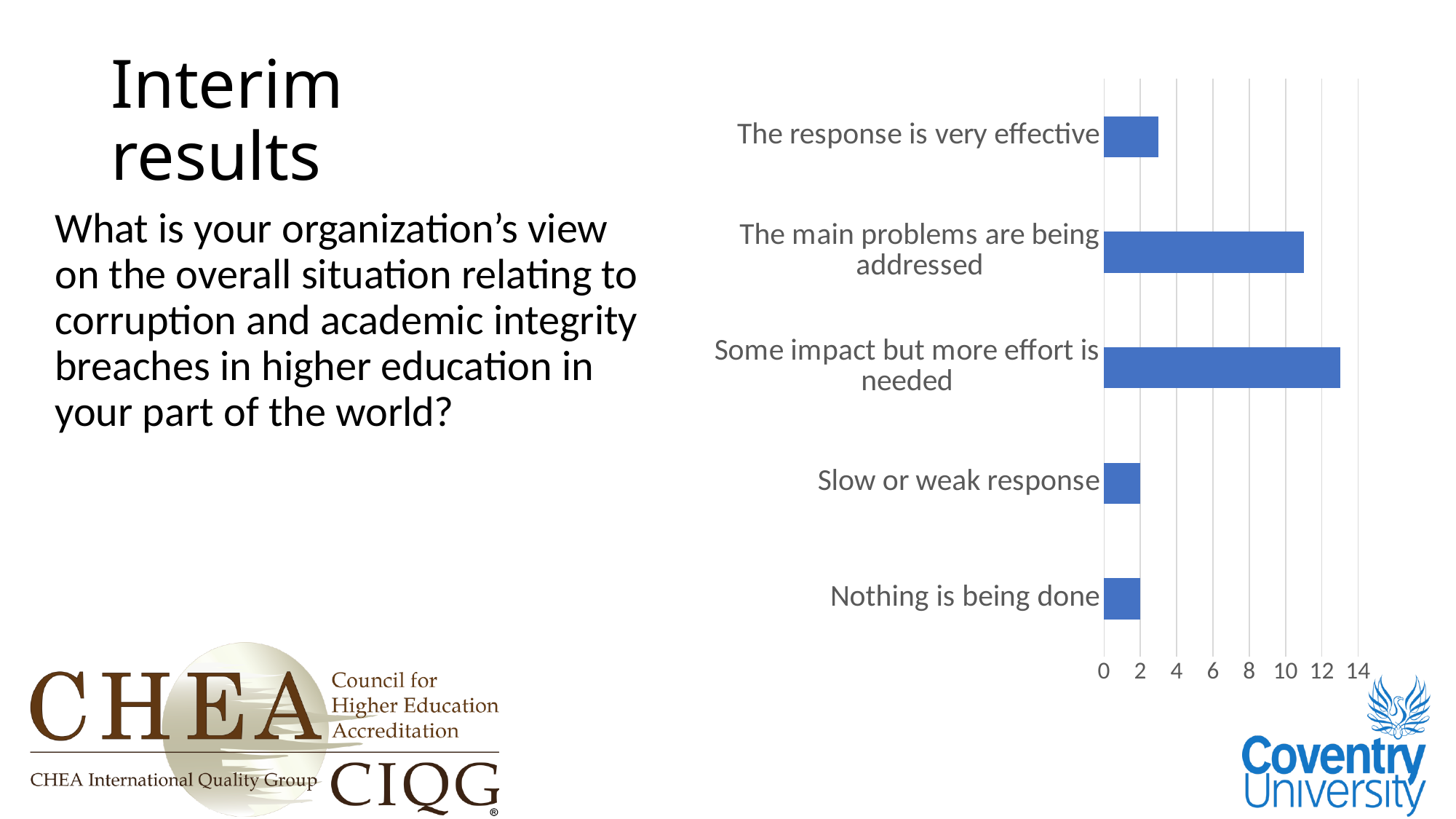
Which is larger: the value for "The response is very effective" or the value for "The main problems are being addressed"? The main problems are being addressed Is the value for "The main problems are being addressed" greater or less than 10? greater Is the value for "The response is very effective" greater or less than 4? less Which category has the highest value in the chart? Some impact but more effort is needed What is the highest value shown on the chart's horizontal axis? 14 How many categories are plotted in the chart? 5 What colour are the bars in the chart? blue What is the value for "Nothing is being done"? 2 Is the value for "Some impact but more effort is needed" greater or less than 12? greater What kind of chart is shown on the slide? bar chart What is the value for "Slow or weak response"? 2 Which is larger: the value for "Some impact but more effort is needed" or the value for "The main problems are being addressed"? Some impact but more effort is needed